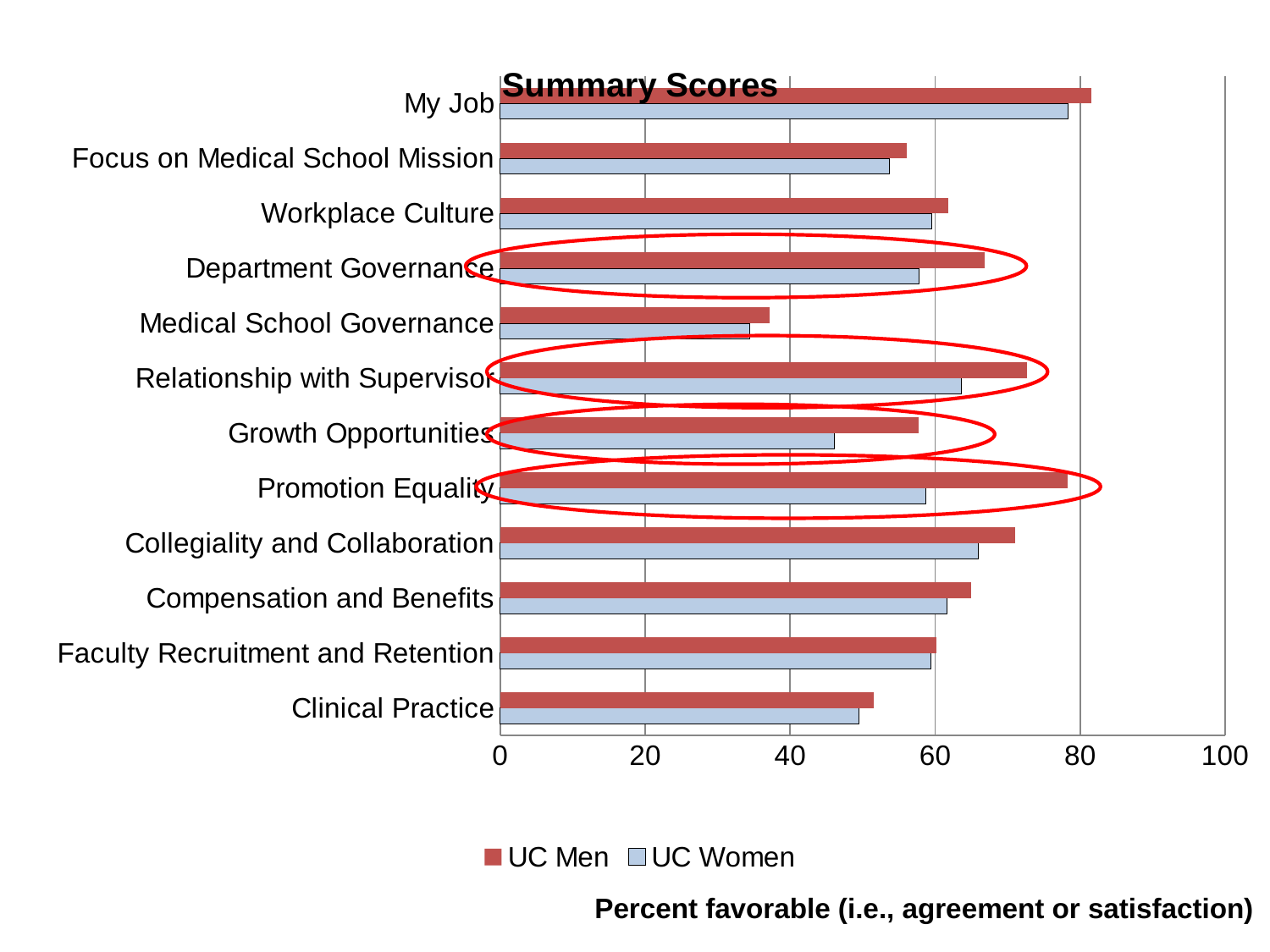
What is the title of the chart? Summary Scores Is the value for UC Women in Growth Opportunities greater or less than 60? less For Promotion Equality, which series has the larger value, UC Men or UC Women? UC Men How many series does the legend list? 2 What kind of chart is shown on the slide? Bar chart Which category has the highest value for UC Men? My Job Which category has the lowest value for UC Men? Medical School Governance Is the value for UC Men in Relationship with Supervisor greater or less than 60? greater Which category has the lowest value for UC Women? Medical School Governance How many categories are plotted on the chart? 12 For Growth Opportunities, which series has the larger value, UC Men or UC Women? UC Men Is the value for UC Men in Medical School Governance greater or less than 40? less